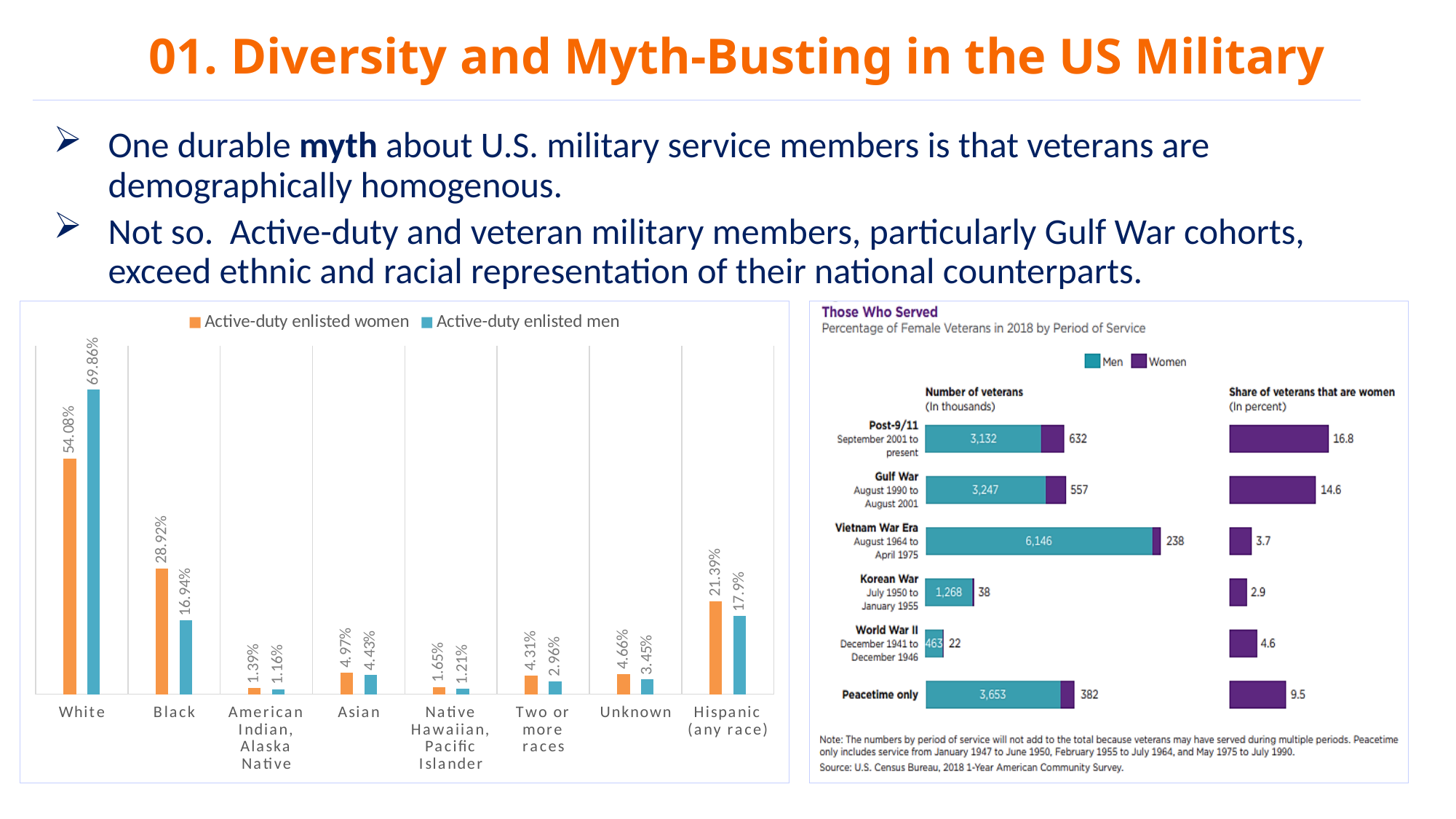
How many categories are shown on the x axis of the left chart? 8 In the left chart, what is the value for Active-duty enlisted women in the White category? 54.08% In the 'Those Who Served' chart, what is the total number of veterans (in thousands) for the Gulf War, men and women combined? 3,804 In the left chart, what is the value for Active-duty enlisted men in the Hispanic (any race) category? 17.9% In the 'Those Who Served' chart, which period of service has the highest share of veterans that are women? Post-9/11 In the left chart, which category has the highest value for Active-duty enlisted men? White In the left chart, which is larger in the Asian category: Active-duty enlisted women or Active-duty enlisted men? Active-duty enlisted women How many series does the legend of the left chart list? 2 In the left chart, what is the difference between Active-duty enlisted women and Active-duty enlisted men in the Black category? 11.98% In the 'Those Who Served' chart, how many male veterans (in thousands) are shown for the Vietnam War Era? 6,146 In the left chart, which category has the lowest value for Active-duty enlisted women? American Indian, Alaska Native What kind of chart is the left chart? Bar chart